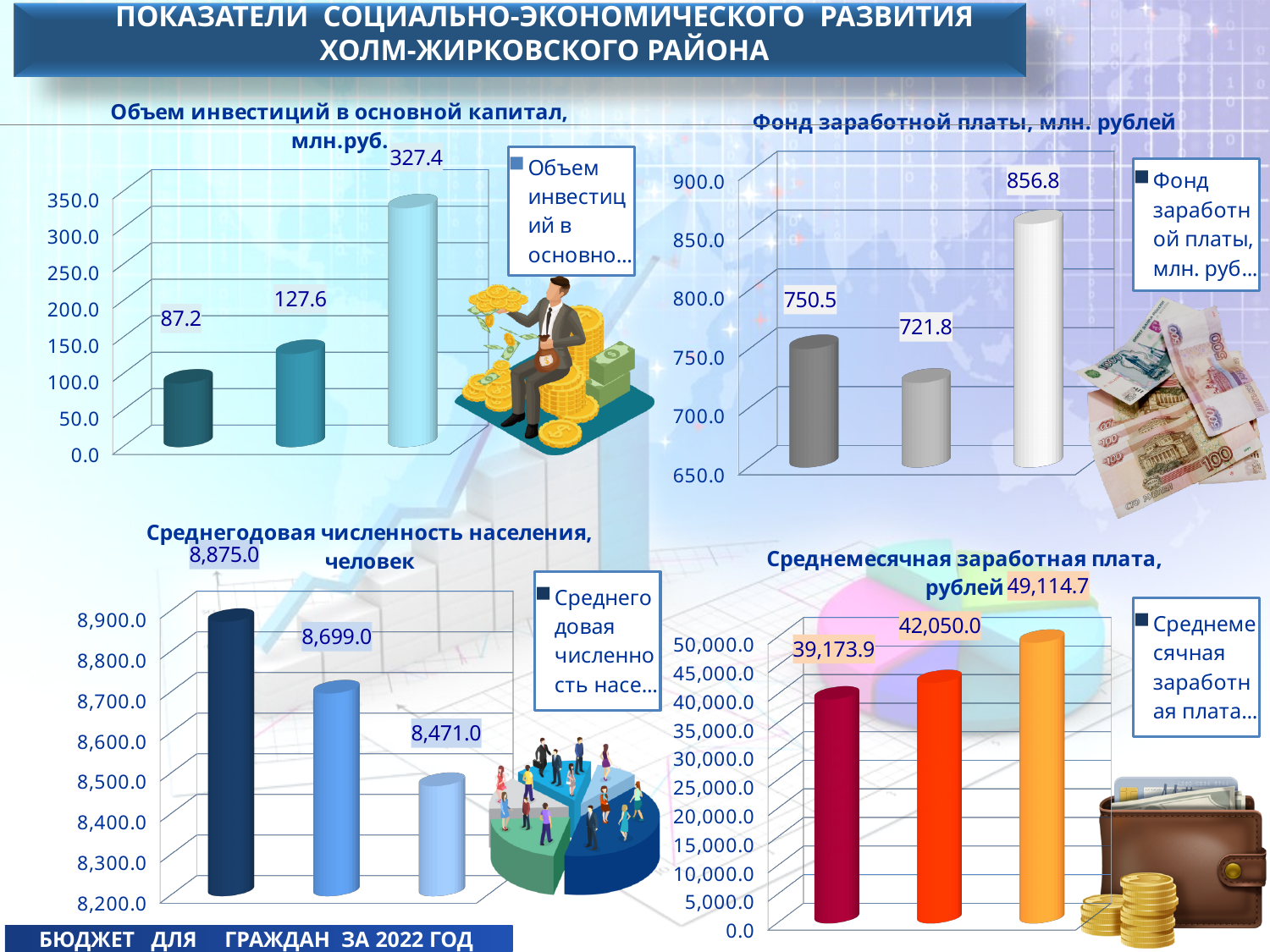
In the chart 'Объем инвестиций в основной капитал, млн.руб.', what is the difference between the tallest and the shortest bar? 240.2 How many bars are plotted in the chart 'Среднегодовая численность населения, человек'? 3 In the chart 'Среднегодовая численность населения, человек', what is the difference between the first and the last bar? 404.0 In the chart 'Объем инвестиций в основной капитал, млн.руб.', what is the highest value shown? 327.4 In the chart 'Фонд заработной платы, млн. рублей', what is the value of the rightmost bar? 856.8 In the chart 'Среднегодовая численность населения, человек', do the values rise or fall from left to right? fall In the chart 'Объем инвестиций в основной капитал, млн.руб.', what is the value of the leftmost bar? 87.2 In the chart 'Фонд заработной платы, млн. рублей', what is the difference between the first and the second bar? 28.7 What kind of chart is 'Среднемесячная заработная плата, рублей'? bar chart In the chart 'Фонд заработной платы, млн. рублей', what is the lowest value shown? 721.8 In the chart 'Среднемесячная заработная плата, рублей', what is the value of the middle bar? 42,050.0 How many series does the legend of the chart 'Среднемесячная заработная плата, рублей' list? 1